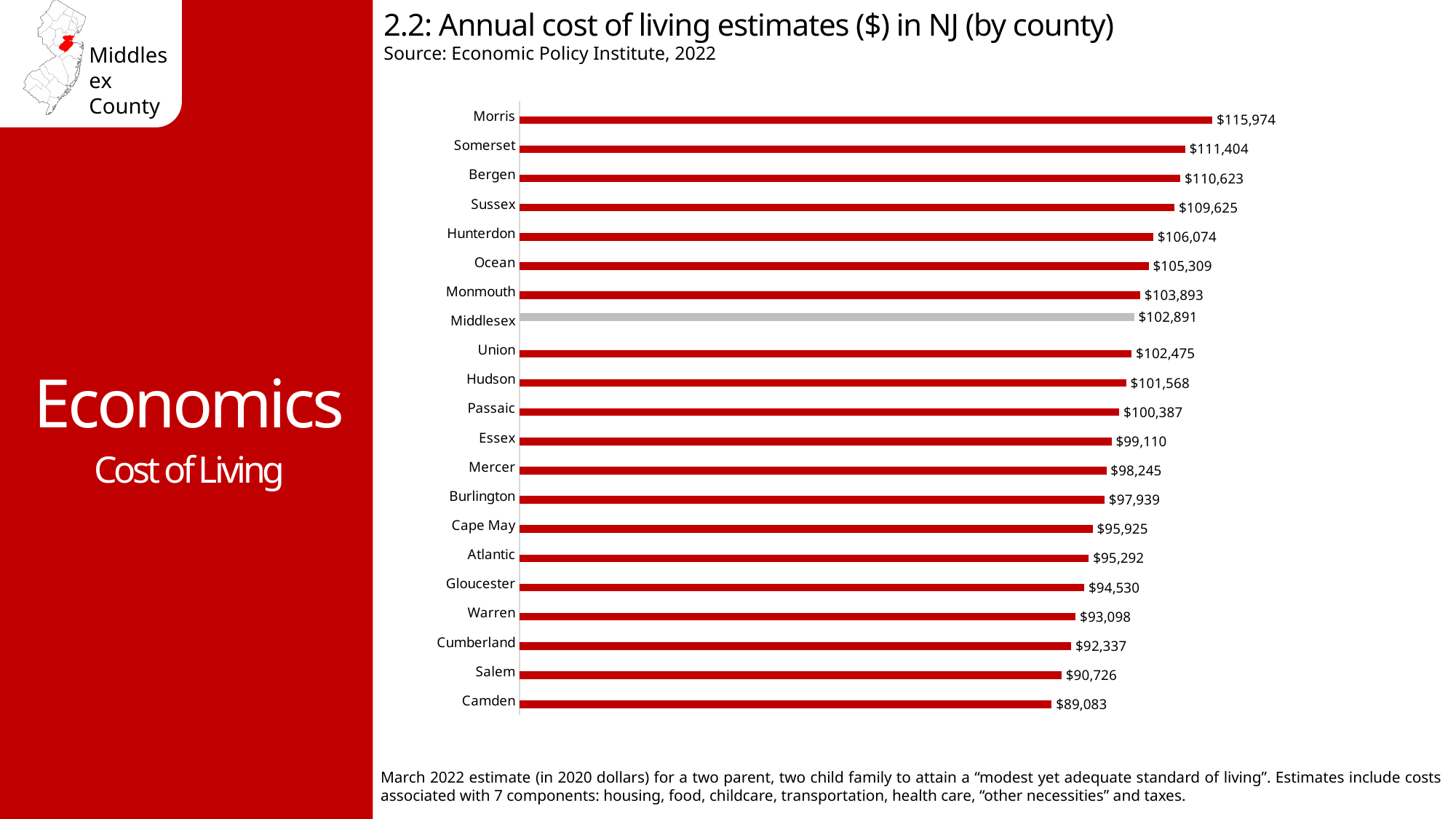
What is the annual cost of living estimate for Cape May County? $95,925 What is the difference between the cost of living estimates for Morris and Camden counties? $26,891 Which county has the lowest annual cost of living estimate? Camden How many counties are shown in the chart? 21 What is the annual cost of living estimate for Hunterdon County? $106,074 What type of chart is used to show the cost of living estimates? Bar chart Do the values rise or fall going from the top of the chart to the bottom? Fall Which county's bar is coloured grey instead of red? Middlesex Which county has the highest annual cost of living estimate? Morris What is the annual cost of living estimate for Middlesex County? $102,891 What is the difference between the cost of living estimates for Middlesex and Union counties? $416 Which county has a higher cost of living estimate, Bergen or Sussex? Bergen